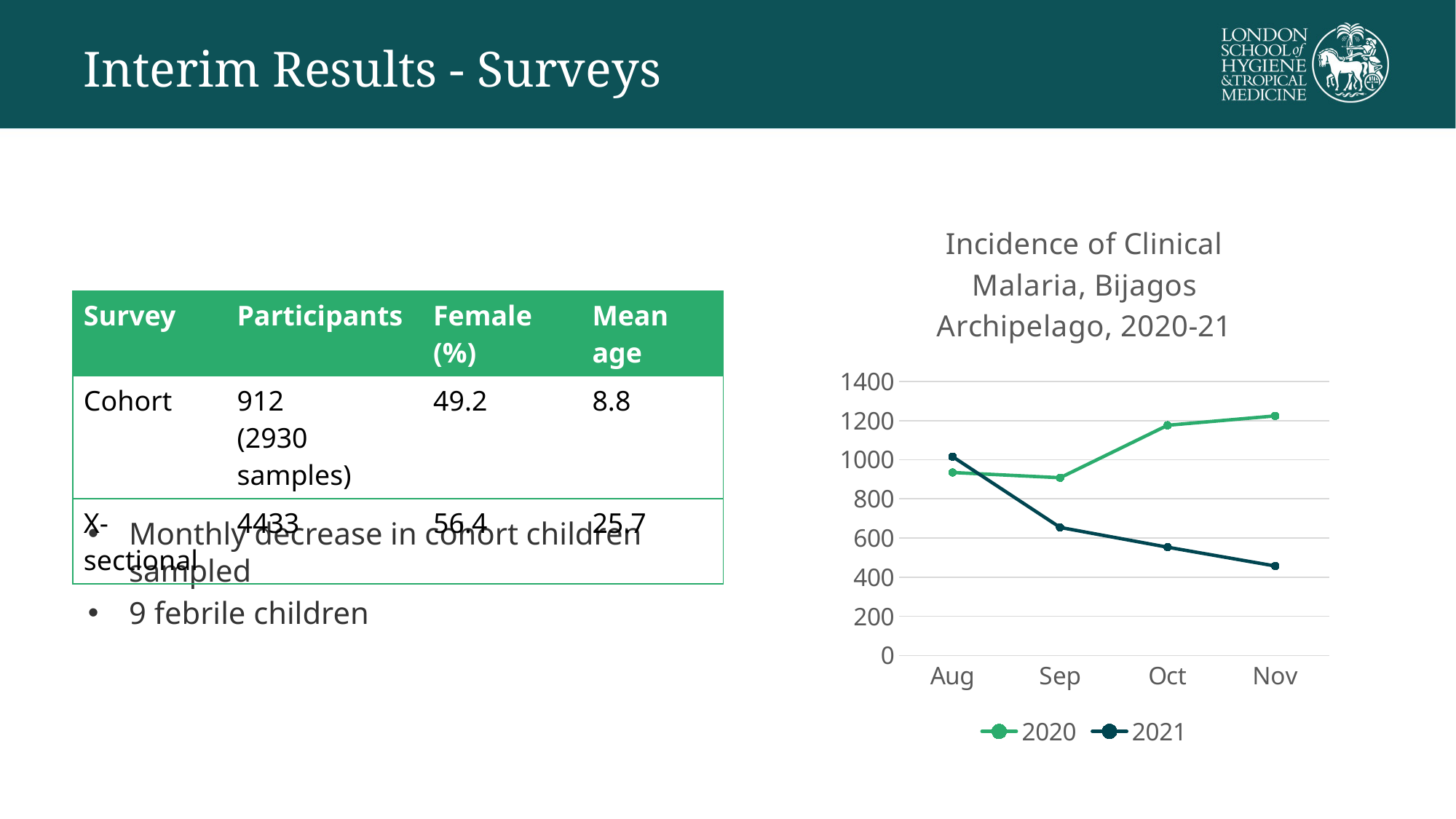
How many months are shown on the x axis of the chart? 4 In Oct, which series has the larger value, 2020 or 2021? 2020 What kind of chart is shown on the slide? line chart Is the value for 2020 in Nov greater or less than 1000? greater In which month is the 2021 series lowest? Nov Is the value for 2021 in Nov greater or less than 600? less In which month is the 2020 series highest? Nov How many series does the chart's legend list? 2 What is the title of the chart? Incidence of Clinical Malaria, Bijagos Archipelago, 2020-21 Is the value for 2021 in Aug greater or less than 800? greater Does the 2021 series rise or fall from Aug to Nov? fall In which month is the 2021 series highest? Aug